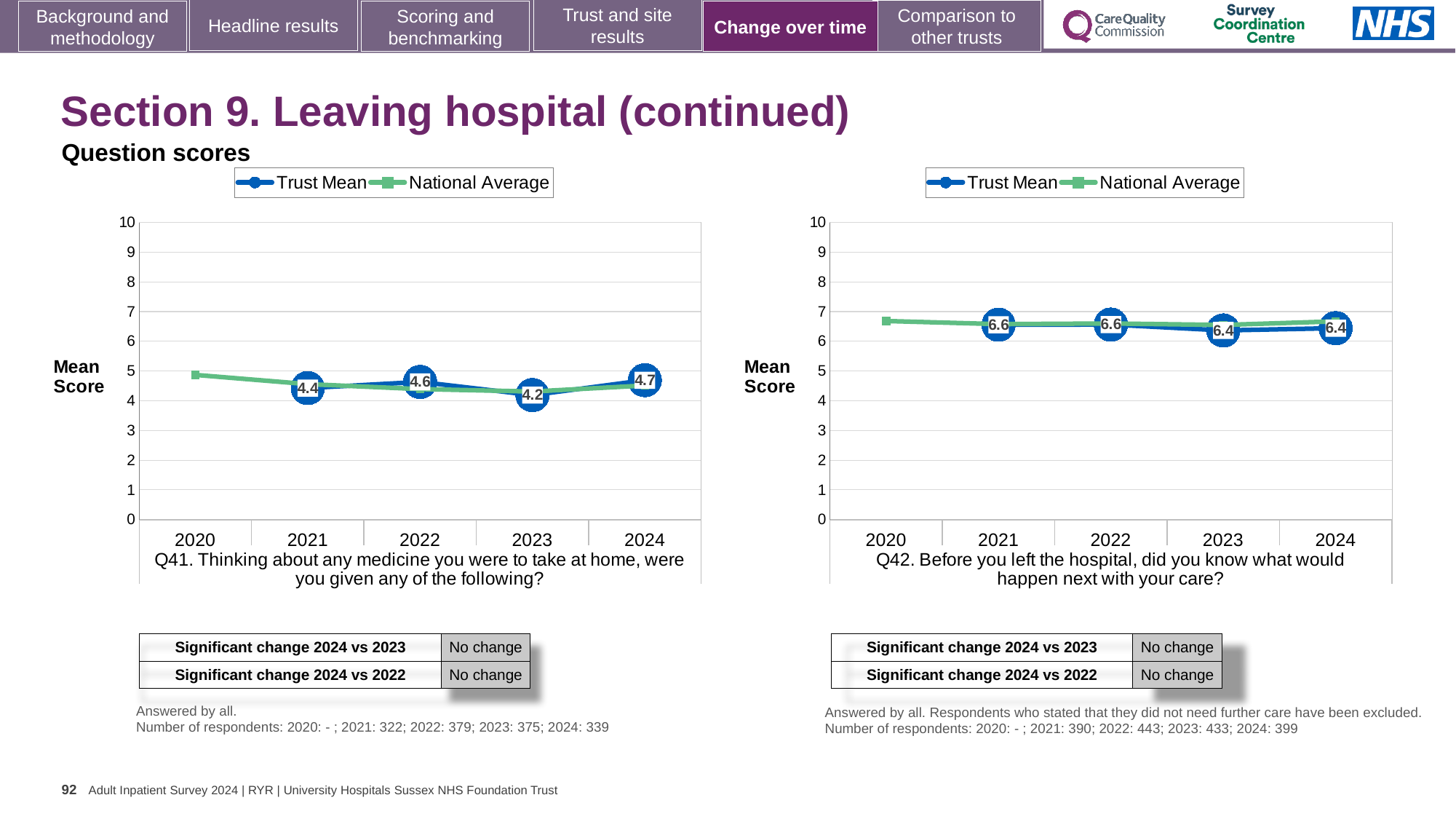
In the Q41 chart (left), what is the Trust Mean score for 2024? 4.7 In the Q42 chart (right), what is the Trust Mean score for 2021? 6.6 In the Q41 chart (left), which year has the highest Trust Mean score? 2024 What kind of chart is the Q42 chart (right)? line chart In the Q42 chart (right), is the National Average value for 2020 greater or less than 6? greater In the Q42 chart (right), is the Trust Mean score for 2022 larger or smaller than the score for 2023? larger How many years are shown on the x axis of the Q41 chart (left)? 5 In the Q41 chart (left), what is the Trust Mean score for 2023? 4.2 In the Q41 chart (left), which year has the lowest Trust Mean score? 2023 In the Q41 chart (left), what is the difference between the Trust Mean scores for 2024 and 2023? 0.5 How many series does the legend of the Q41 chart (left) list? 2 In the Q42 chart (right), what is the Trust Mean score for 2024? 6.4